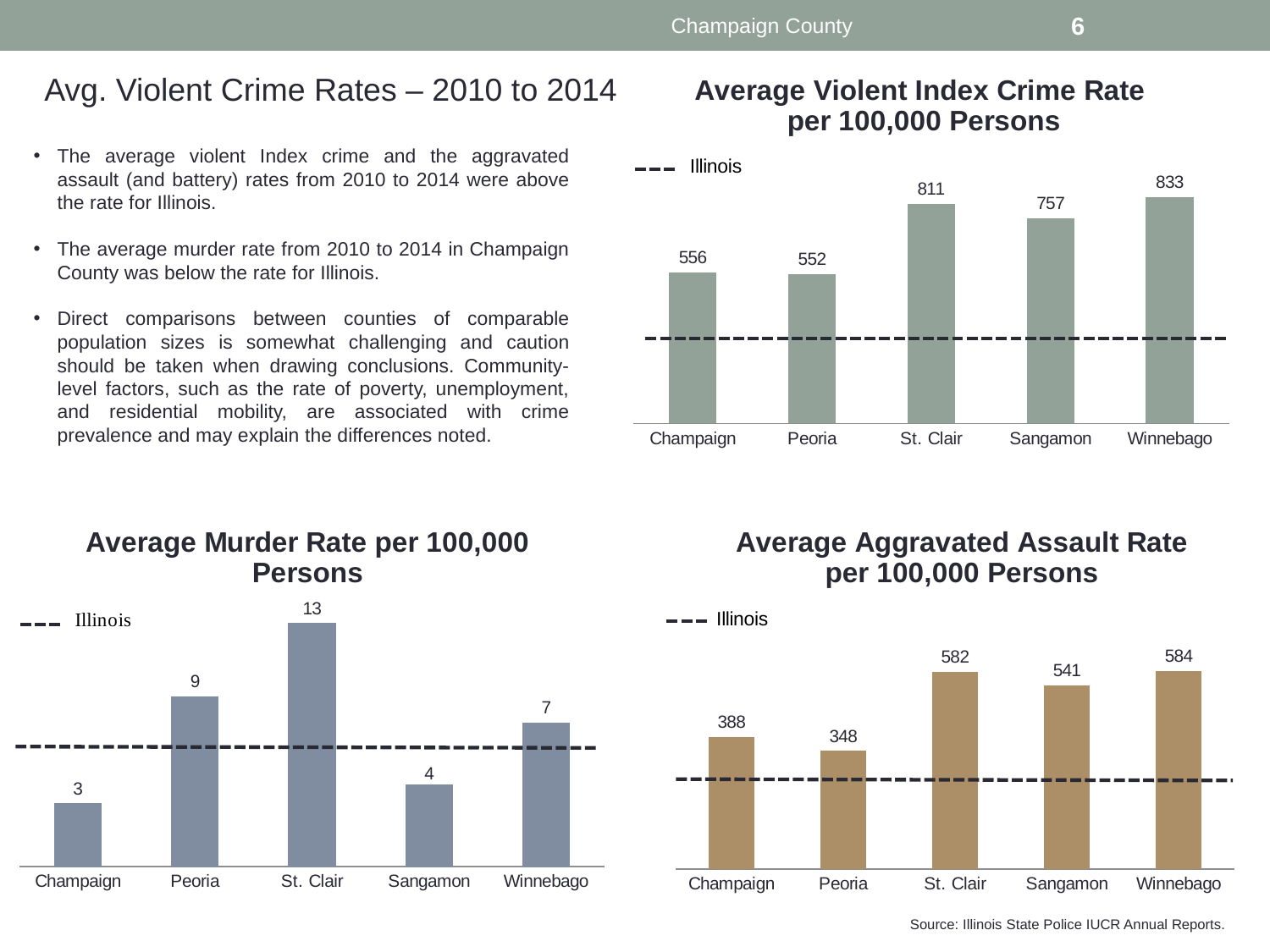
In the Average Violent Index Crime Rate per 100,000 Persons chart, what is the difference between Champaign and Peoria? 4 In the Average Violent Index Crime Rate per 100,000 Persons chart, what is the value for St. Clair? 811 In the Average Murder Rate per 100,000 Persons chart, what is the difference between St. Clair and Sangamon? 9 In the Average Murder Rate per 100,000 Persons chart, what is the value for Champaign? 3 In the Average Murder Rate per 100,000 Persons chart, which county has the lowest rate? Champaign In the Average Aggravated Assault Rate per 100,000 Persons chart, which county has the lowest rate? Peoria In the Average Murder Rate per 100,000 Persons chart, which county has the highest rate? St. Clair In the Average Violent Index Crime Rate per 100,000 Persons chart, which county has the highest rate? Winnebago What kind of chart is the Average Murder Rate per 100,000 Persons chart? Bar chart In the Average Aggravated Assault Rate per 100,000 Persons chart, what is the value for Sangamon? 541 In the Average Aggravated Assault Rate per 100,000 Persons chart, which is larger, Champaign or Peoria? Champaign How many counties are shown in the Average Aggravated Assault Rate per 100,000 Persons chart? 5